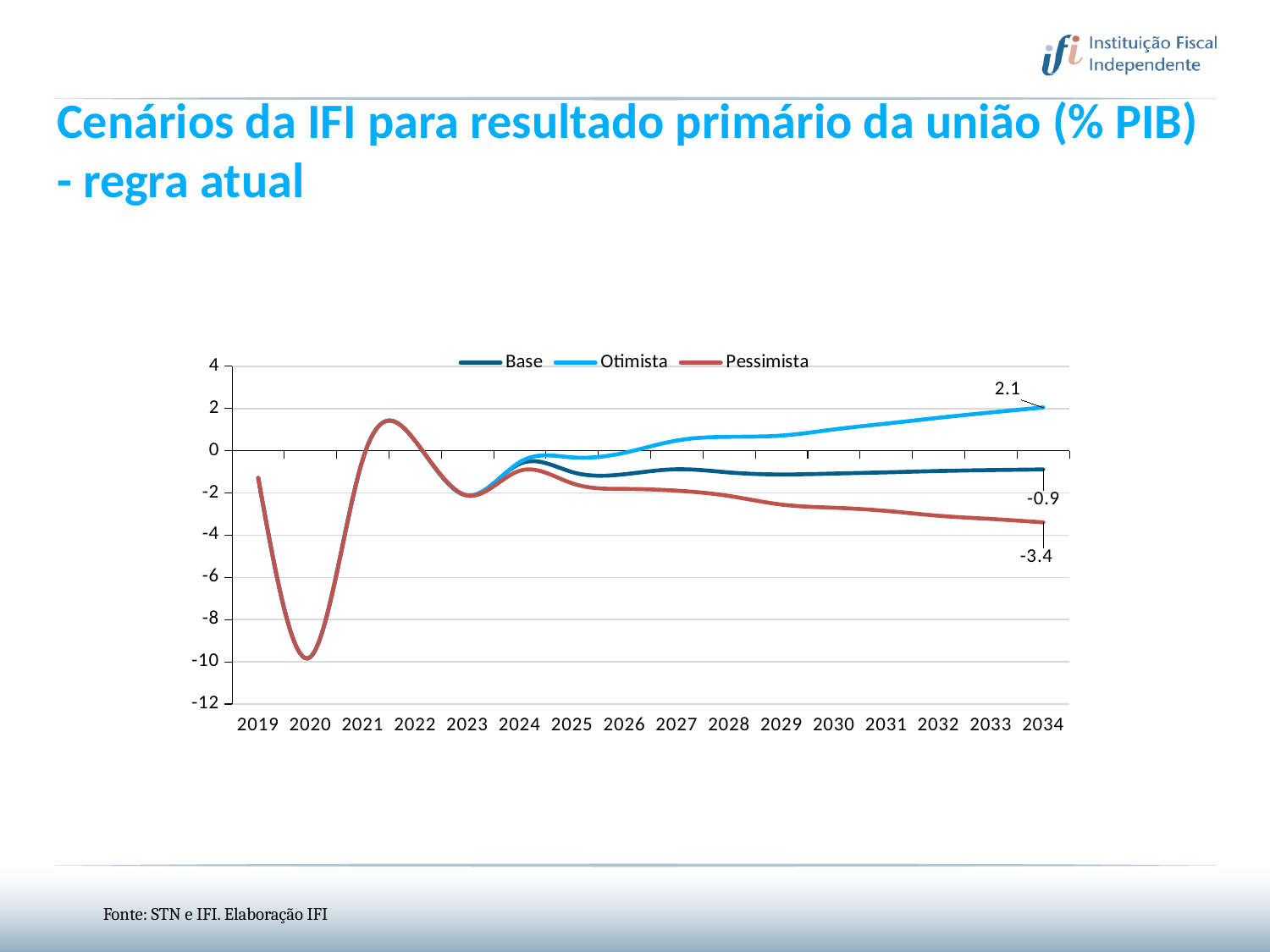
Which series has the lowest value in 2034? Pessimista What kind of chart is shown on the slide? line chart What is the difference between the Base and Pessimista values in 2034? 2.5 Is the Pessimista value in 2030 greater or less than -2? less In 2034, which is larger: the Base value or the Otimista value? Otimista Is the value in 2020 greater or less than -8? less What is the data label for the Pessimista series in 2034? -3.4 How many series does the legend list? 3 Which series has the highest value in 2034? Otimista What is the data label for the Base series in 2034? -0.9 What is the difference between the Otimista and Pessimista values in 2034? 5.4 What is the data label for the Otimista series in 2034? 2.1